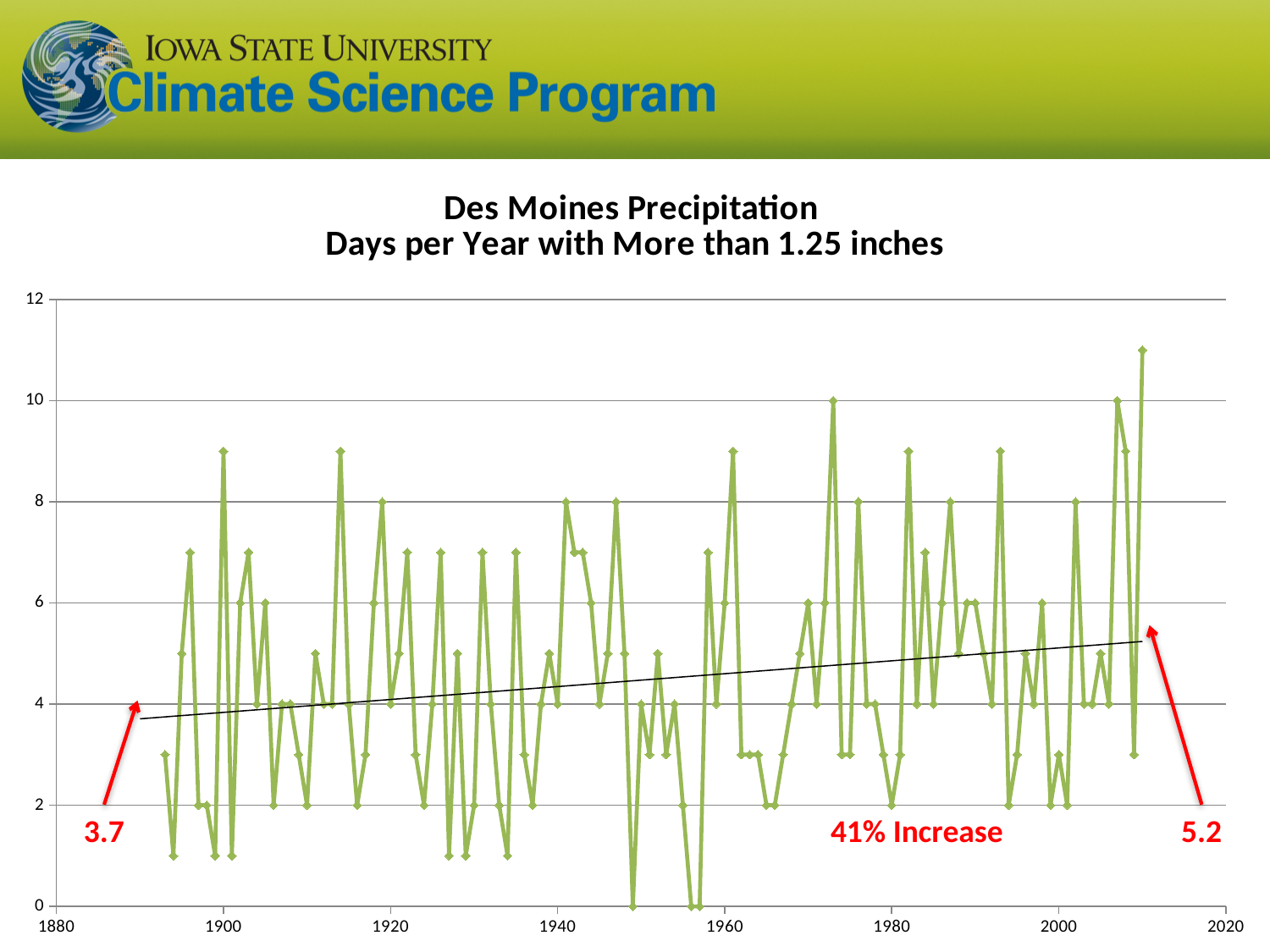
Is the highest point on the line greater or less than 10? greater How many data series are plotted on the chart? 1 What is the difference between the trend line's end value (5.2) and its start value (3.7)? 1.5 What percentage increase is annotated on the chart? 41% Increase What value is labelled at the start of the trend line (around 1890)? 3.7 What is the title of the chart? Des Moines Precipitation Days per Year with More than 1.25 inches Is the lowest point on the line greater or less than 2? less What kind of chart is shown on the slide? line chart What is the maximum value shown on the y axis? 12 What value is labelled at the end of the trend line (around 2010)? 5.2 Which is larger, the trend line value at the start (3.7) or at the end (5.2)? 5.2 (end) Does the trend line rise or fall from 1890 to 2010? rise